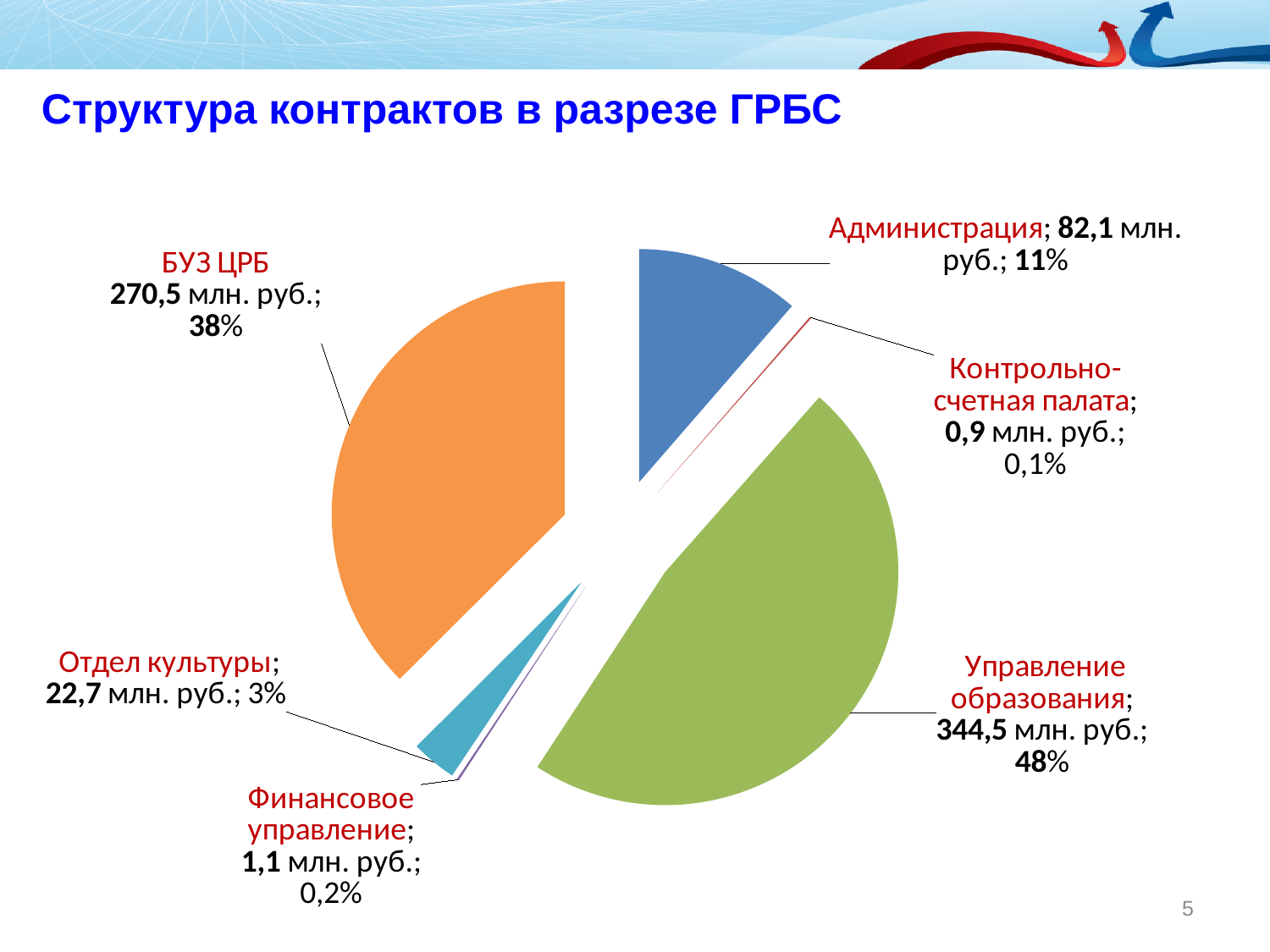
Which is larger, the value for Отдел культуры or the value for Финансовое управление? Отдел культуры What is the value for Управление образования? 344,5 млн. руб. Which category has the largest slice? Управление образования What is the title of the slide? Структура контрактов в разрезе ГРБС What is the value for Отдел культуры? 22,7 млн. руб. What kind of chart is shown on the slide? Pie chart What share of the pie does БУЗ ЦРБ account for? 38% How many categories are shown in the pie chart? 6 What share of the pie does Контрольно-счетная палата account for? 0,1% What is the value for Администрация? 82,1 млн. руб. What is the difference between the values for Управление образования and Администрация? 262,4 млн. руб. Which category has the smallest slice? Контрольно-счетная палата